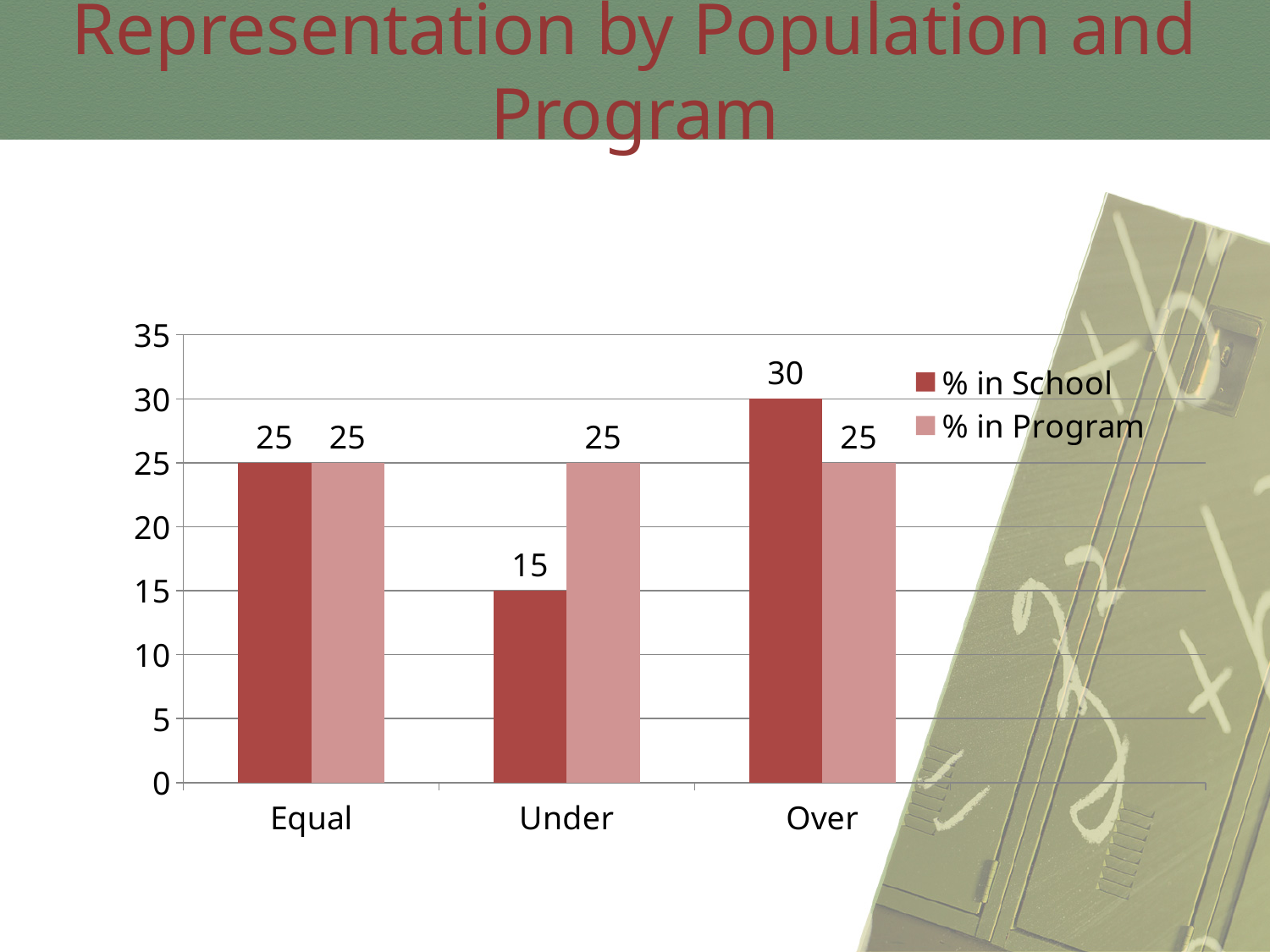
What is the difference between % in School and % in Program for the Over category? 5 What is the title of the slide containing the chart? Representation by Population and Program How many series does the legend list? 2 What is the % in School value for the Under category? 15 What is the % in Program value for the Over category? 25 What is the % in School value for the Equal category? 25 How many categories are shown on the x axis? 3 What is the difference between % in Program and % in School for the Under category? 10 Which category has the highest % in School value? Over For the Under category, which is larger: % in School or % in Program? % in Program What type of chart is shown on the slide? Bar chart Which category has the lowest % in School value? Under